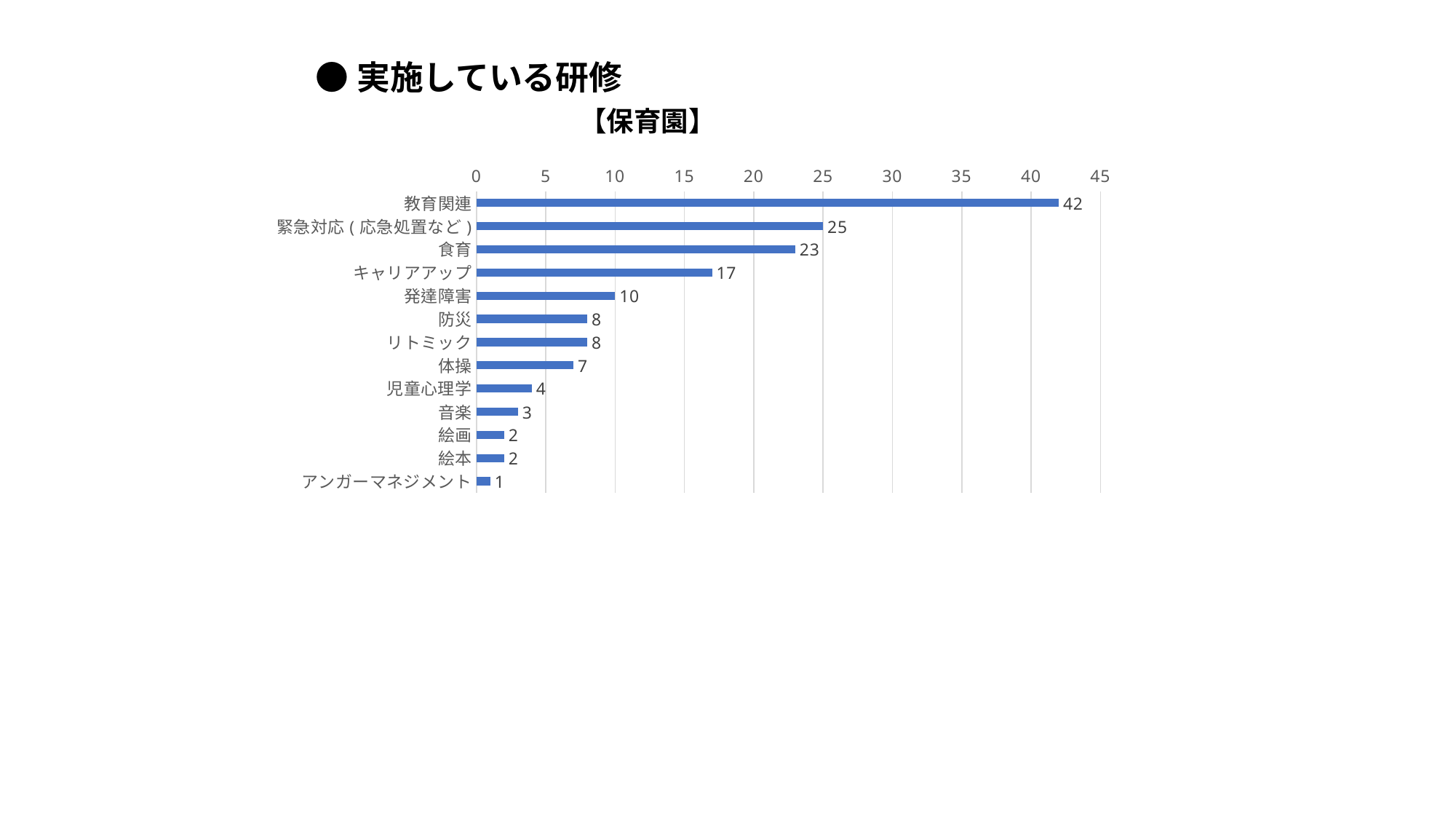
Which is larger, the value for 発達障害 or the value for 体操? 発達障害 What is the value for 教育関連? 42 What is the value for 緊急対応 ( 応急処置など )? 25 What kind of chart is shown on the slide? Bar chart What is the value for キャリアアップ? 17 Which category has the highest value? 教育関連 What is the value for 児童心理学? 4 What is the title shown above the chart? 【保育園】 Which category has the lowest value? アンガーマネジメント What is the difference between the values for 教育関連 and 食育? 19 What is the difference between the values for 緊急対応 ( 応急処置など ) and 発達障害? 15 How many categories are shown in the chart? 13